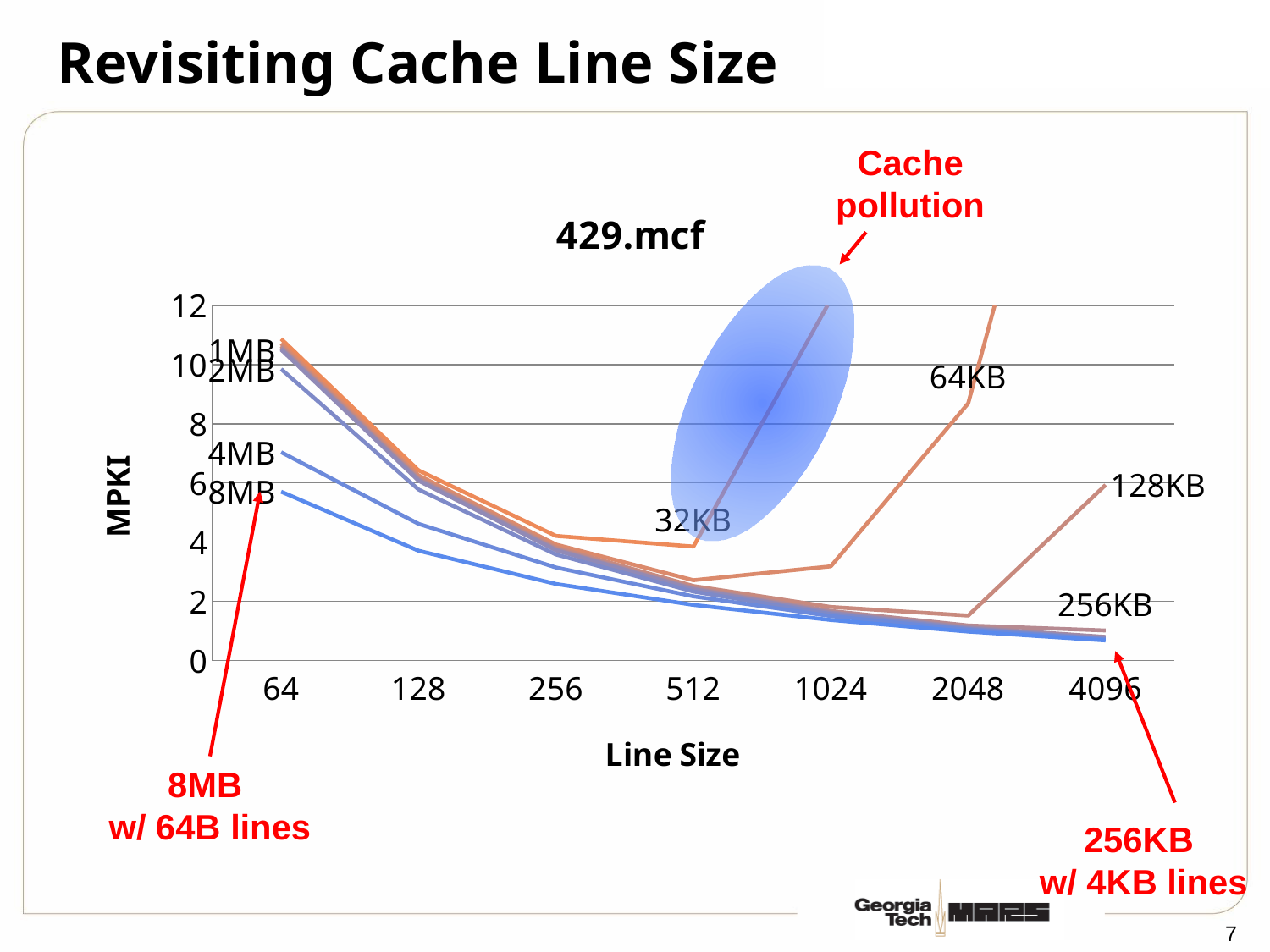
How many line size values are shown on the x axis? 7 Is the MPKI for the 1MB series at line size 64 greater or less than 10? greater What kind of chart is shown on the slide? line chart Is the MPKI for the 64KB series at line size 2048 greater or less than 8? greater Does the MPKI for the 8MB series rise or fall as line size increases? fall How many cache-size series are labelled on the chart? 8 Which series has the lowest MPKI at line size 64? 8MB Is the MPKI for the 128KB series at line size 2048 greater or less than 2? less What is the label of the y axis? MPKI At line size 64, which has the higher MPKI, the 4MB series or the 8MB series? 4MB What is the title of the chart? 429.mcf